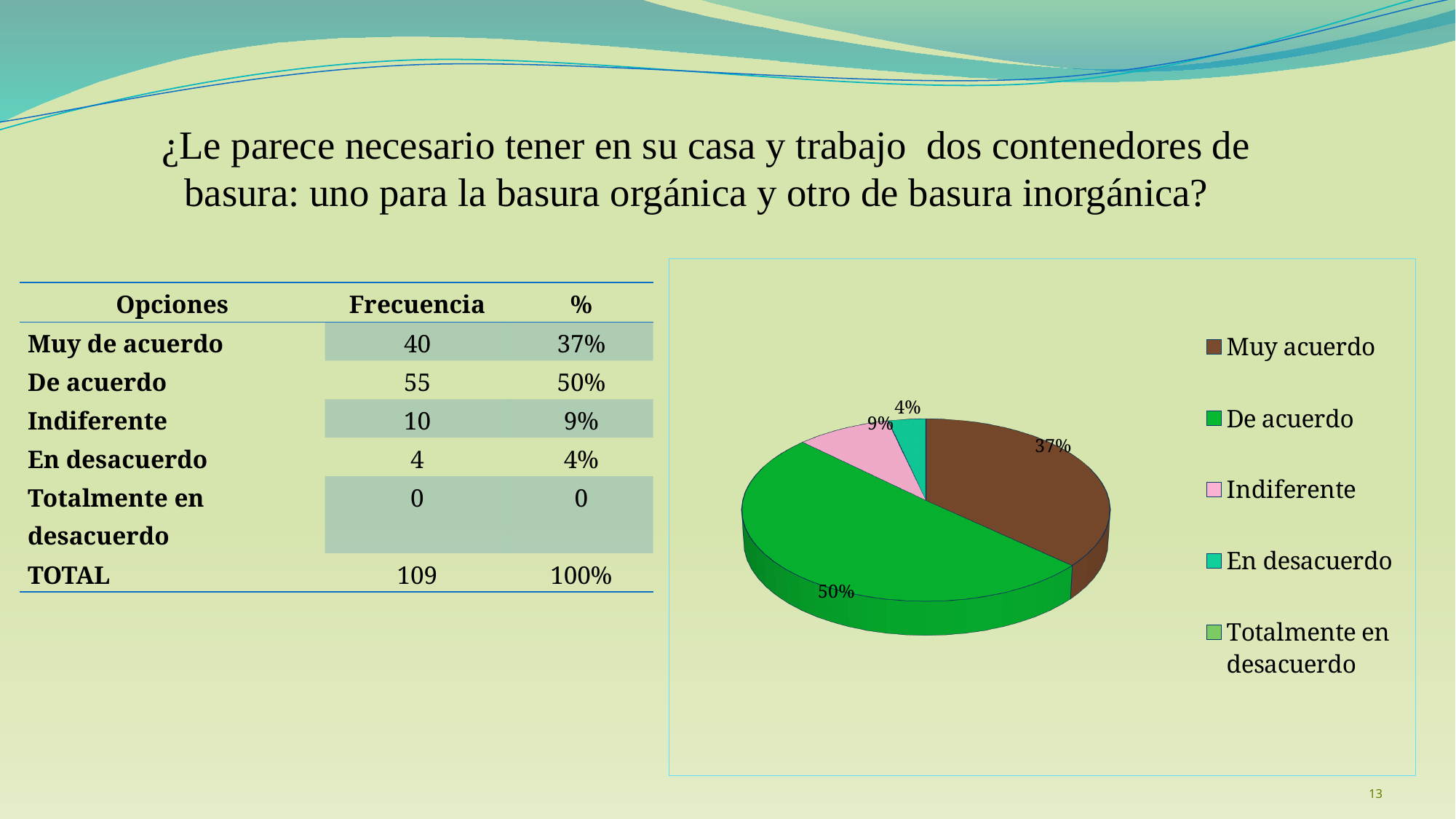
What colour is the De acuerdo slice in the pie chart? Green What kind of chart is shown on the slide? Pie chart What percentage does the pie chart show for Indiferente? 9% Which labelled slice of the pie chart is the smallest? En desacuerdo Which is larger in the pie chart, Indiferente or En desacuerdo? Indiferente What colour is the Muy acuerdo slice in the pie chart? Brown What is the difference in percentage points between De acuerdo and Muy acuerdo in the pie chart? 13 Which category has the largest slice of the pie chart? De acuerdo What percentage does the pie chart show for En desacuerdo? 4% What percentage does the pie chart show for De acuerdo? 50% What percentage does the pie chart show for Muy acuerdo? 37% How many entries does the legend of the pie chart list? 5